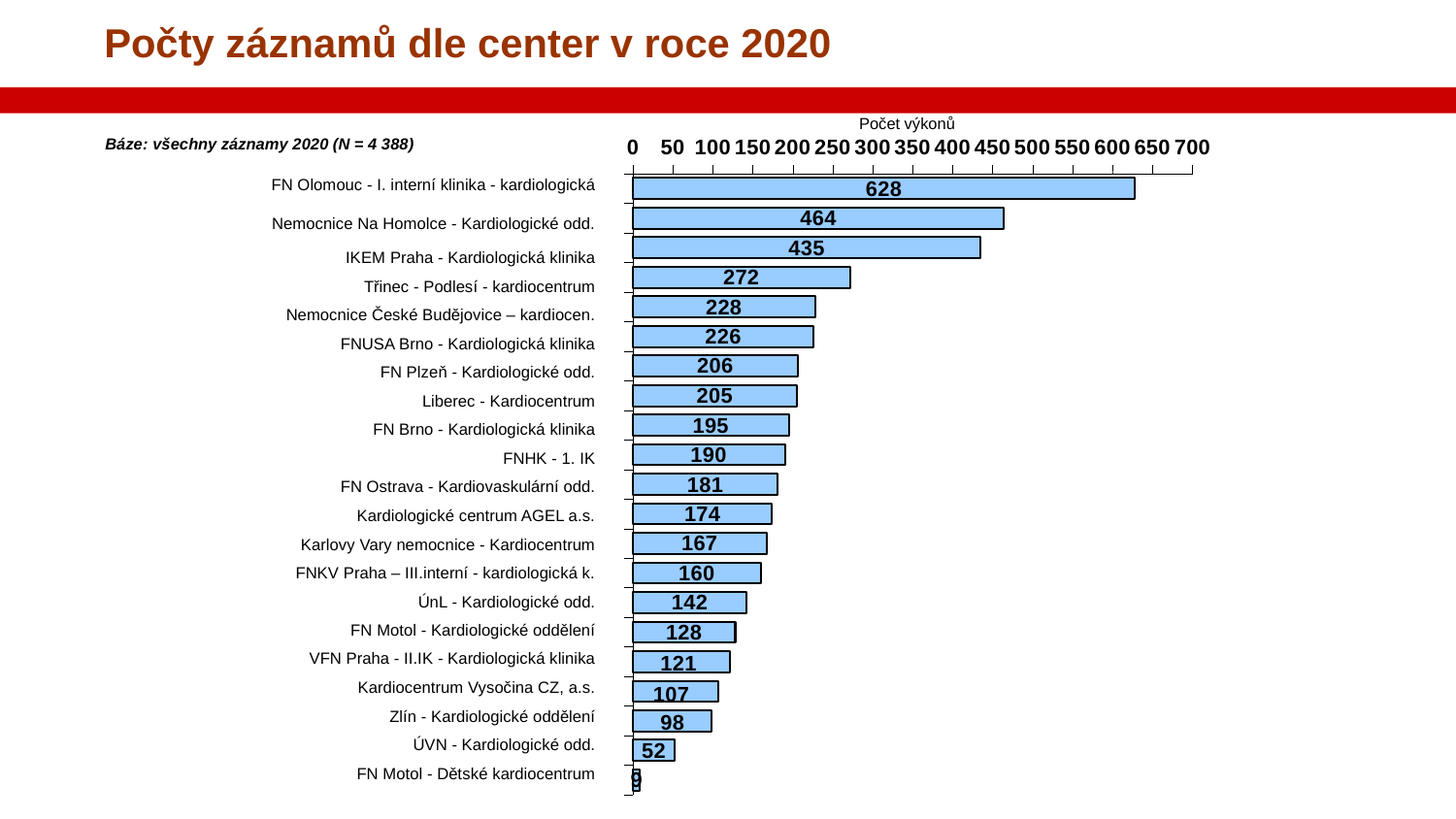
What is the difference between the values for Třinec - Podlesí - kardiocentrum and Nemocnice České Budějovice – kardiocen.? 44 Which center has the highest value? FN Olomouc - I. interní klinika - kardiologická What is the value for FN Olomouc - I. interní klinika - kardiologická? 628 What is the value for Zlín - Kardiologické oddělení? 98 Which center has the lowest value? FN Motol - Dětské kardiocentrum What is the label of the value axis of the chart? Počet výkonů What kind of chart is shown on the slide? Bar chart What is the value for IKEM Praha - Kardiologická klinika? 435 Which has a larger value, Třinec - Podlesí - kardiocentrum or FNUSA Brno - Kardiologická klinika? Třinec - Podlesí - kardiocentrum What is the value for ÚVN - Kardiologické odd.? 52 What is the difference between the values for FN Olomouc - I. interní klinika - kardiologická and Nemocnice Na Homolce - Kardiologické odd.? 164 How many centers are shown in the chart? 21